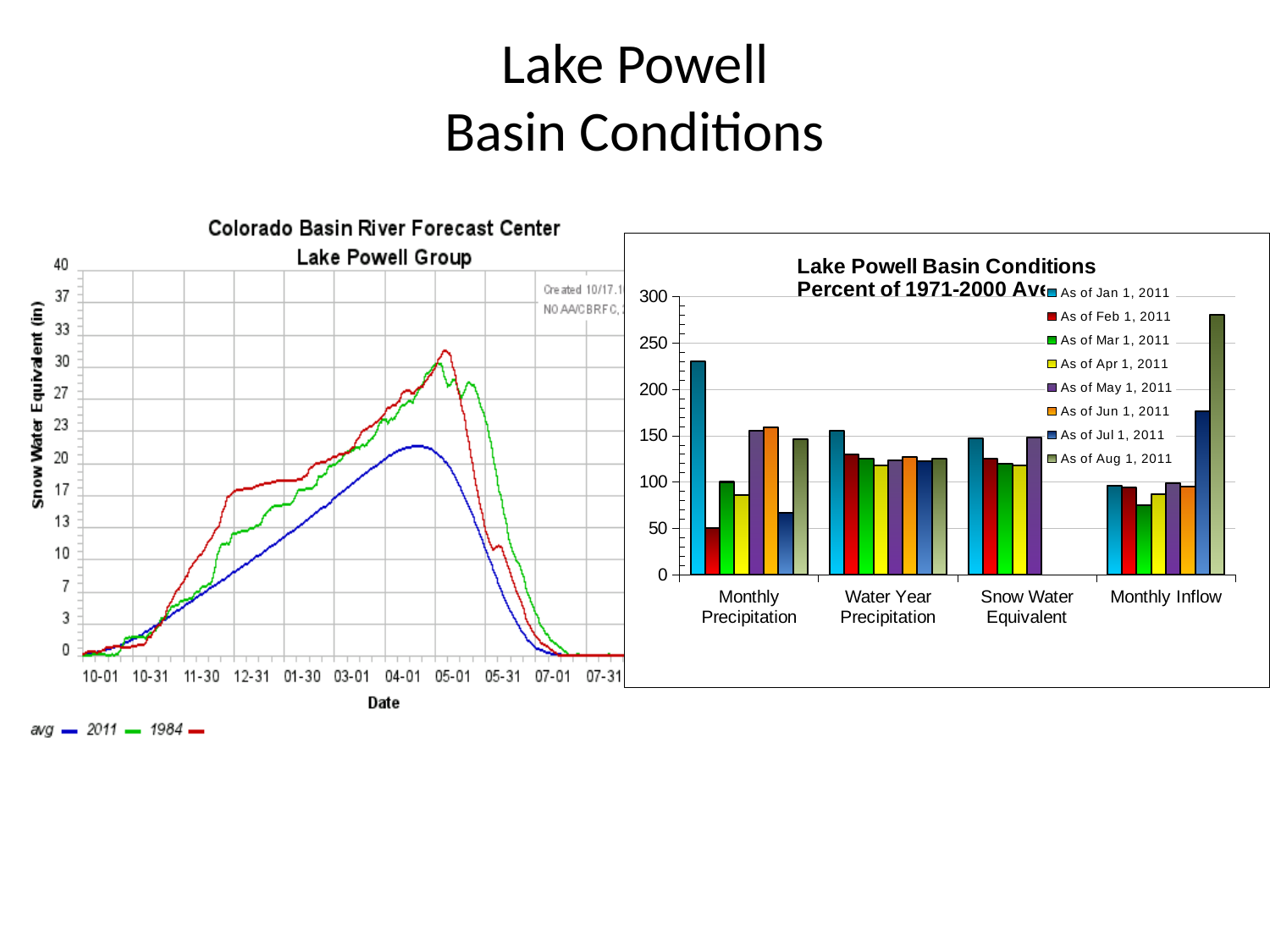
What kind of chart is the Lake Powell Basin Conditions chart on the right? bar chart In the Colorado Basin River Forecast Center Lake Powell Group line chart, is the peak of the avg line greater or less than 27 inches? less In the Colorado Basin River Forecast Center Lake Powell Group line chart, what is the label of the y axis? Snow Water Equivalent (in) In the Lake Powell Basin Conditions bar chart, how many categories are shown on the x axis? 4 In the Lake Powell Basin Conditions bar chart, is the Monthly Inflow value for As of Aug 1, 2011 greater or less than 250? greater In the Lake Powell Basin Conditions bar chart, how many series does the legend list? 8 In the Colorado Basin River Forecast Center Lake Powell Group line chart, how many series does the legend list? 3 In the Lake Powell Basin Conditions bar chart, which series has the lowest Monthly Precipitation value? As of Feb 1, 2011 In the Lake Powell Basin Conditions bar chart, which series has the highest Monthly Inflow value? As of Aug 1, 2011 In the Lake Powell Basin Conditions bar chart, is the Monthly Precipitation value for As of Jan 1, 2011 greater or less than 200? greater In the Lake Powell Basin Conditions bar chart, which is larger for Monthly Inflow: As of Jul 1, 2011 or As of Mar 1, 2011? As of Jul 1, 2011